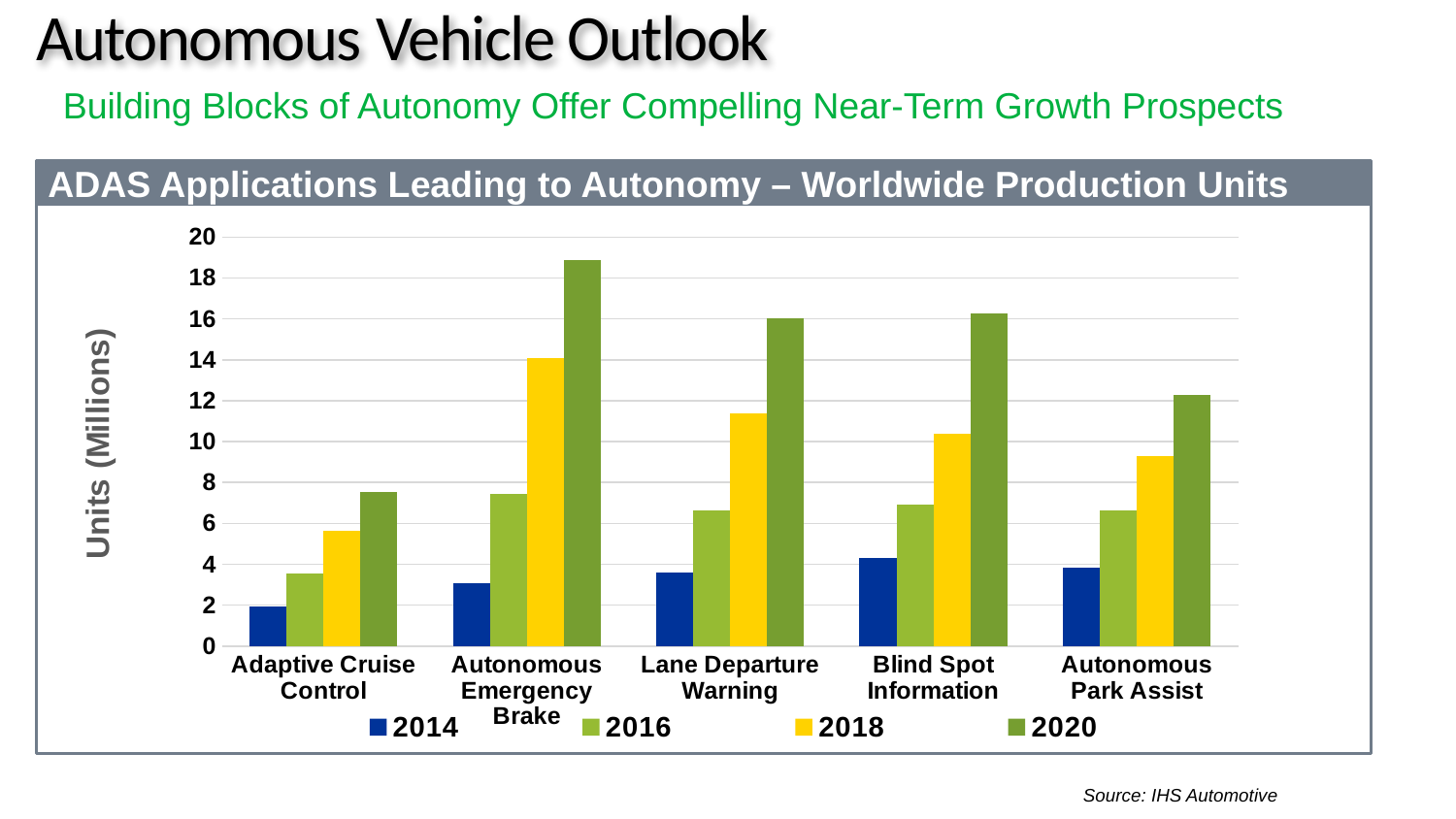
Which category has the lowest 2014 value? Adaptive Cruise Control What kind of chart is shown on the slide? Bar chart What is the label on the y axis of the chart? Units (Millions) Which category has the highest 2014 value? Blind Spot Information Which category has the highest 2020 value? Autonomous Emergency Brake For Autonomous Park Assist, do the values rise or fall from 2014 to 2020? rise How many series does the legend list? 4 Is the 2014 value for Adaptive Cruise Control greater or less than 4? less Is the 2018 value for Lane Departure Warning greater or less than 10? greater Is the 2020 value for Autonomous Emergency Brake greater or less than 18? greater How many ADAS application categories are shown on the x axis? 5 Which is larger: the 2018 value for Autonomous Emergency Brake or the 2018 value for Blind Spot Information? Autonomous Emergency Brake